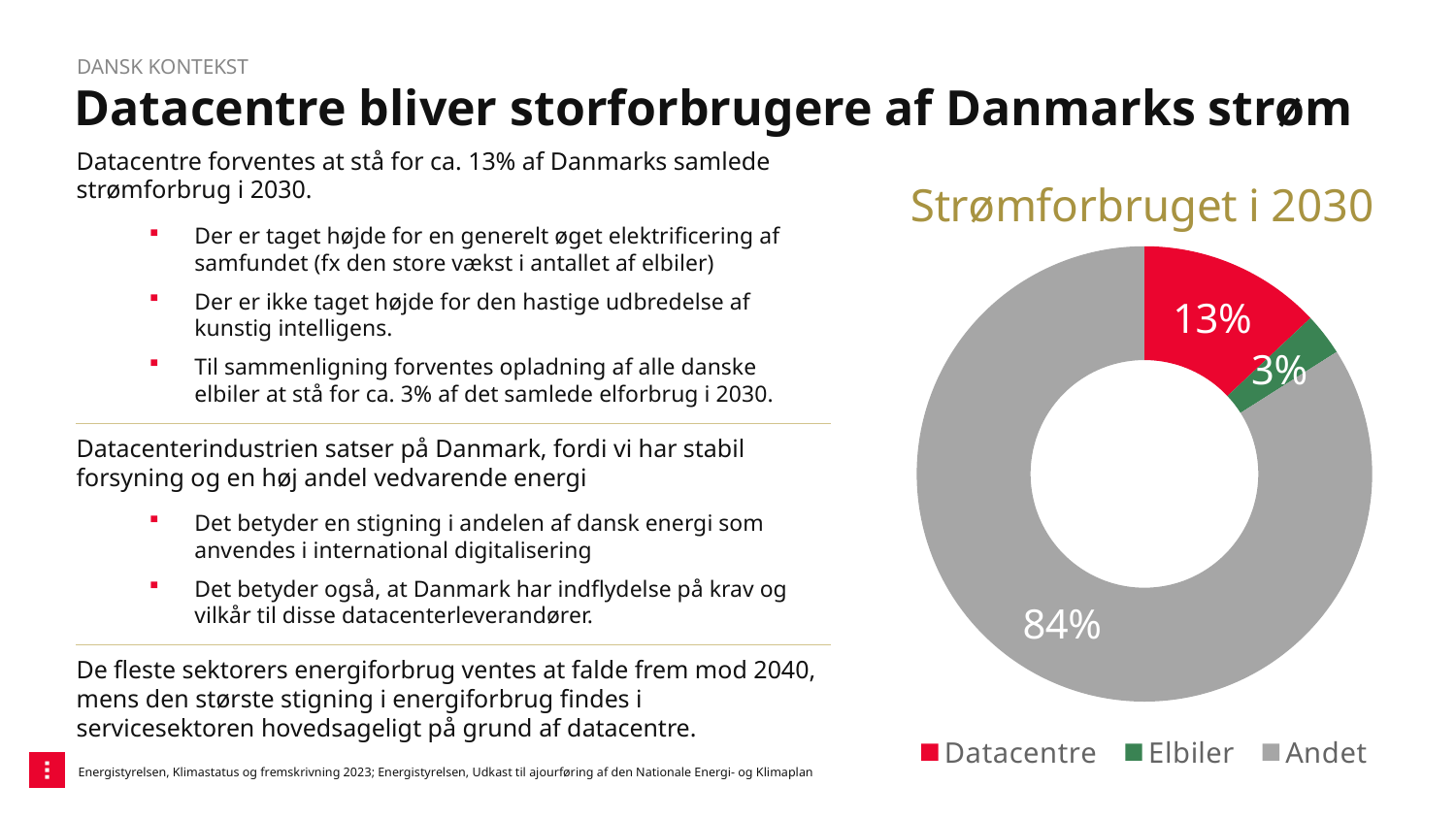
Which category has the largest share of the pie? Andet What colour represents Datacentre in the chart? Red What kind of chart is shown on the slide? Pie chart (doughnut) What share of the pie does Elbiler have? 3% What is the title of the chart? Strømforbruget i 2030 Which category has the smallest share of the pie? Elbiler What share of the pie does Datacentre have? 13% Which is larger, the share for Datacentre or the share for Elbiler? Datacentre How many categories does the legend list? 3 What share of the pie does Andet have? 84% What is the difference in percentage points between Datacentre and Elbiler? 10 percentage points What is the difference in percentage points between Andet and Datacentre? 71 percentage points